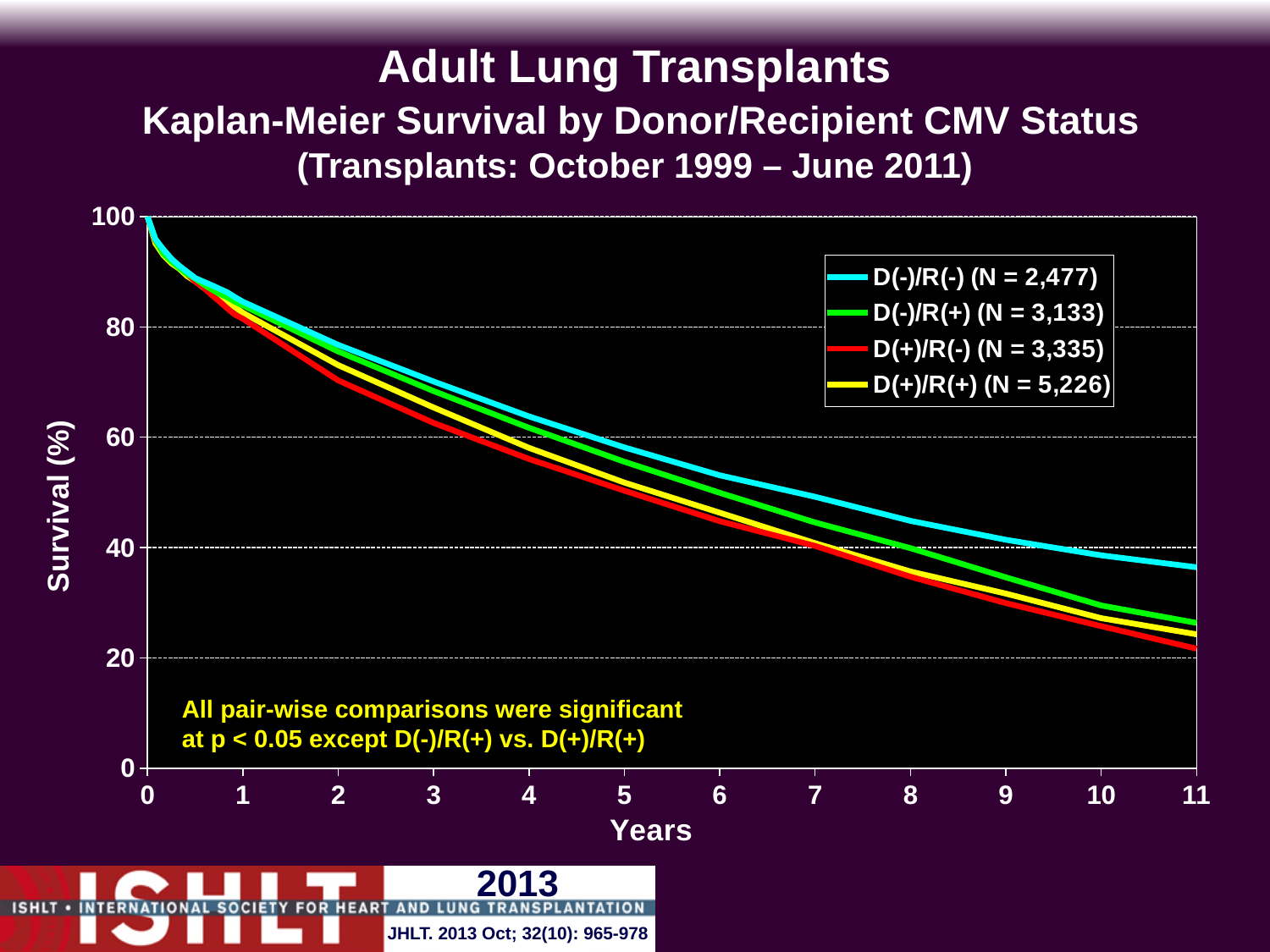
Which CMV status group has the largest N in the legend? D(+)/R(+) What kind of chart is shown on the slide? line chart Is the survival for D(-)/R(-) at 11 years greater or less than 40%? less How many series does the legend list? 4 Do the survival curves rise or fall as years increase? fall Is the survival for D(+)/R(-) at 5 years greater or less than 60%? less What is the N for the D(+)/R(+) group shown in the legend? 5,226 Which group has the lowest survival at 11 years? D(+)/R(-) Which group has the highest survival at 11 years? D(-)/R(-) What is the N for the D(-)/R(-) group shown in the legend? 2,477 What is the difference between the N for D(+)/R(+) and the N for D(-)/R(-)? 2,749 Which CMV status group has the smallest N in the legend? D(-)/R(-)